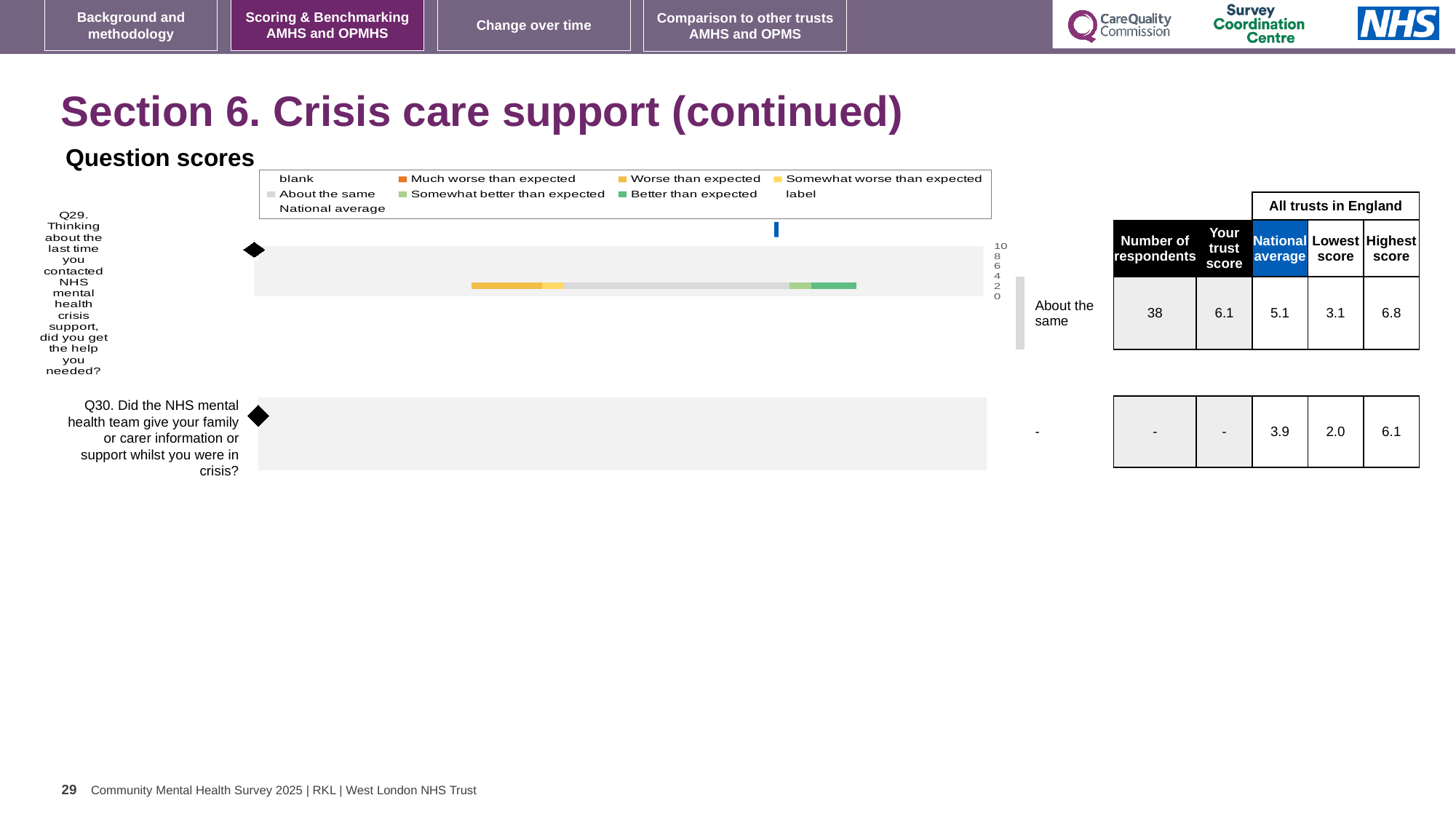
What is the highest score among all trusts in England for Q29? 6.8 How many questions are plotted in the question scores chart? 2 What kind of chart is used to show the question scores on this slide? bar chart What is the national average for Q29? 5.1 What is the trust's score for Q29? 6.1 What is the lowest score among all trusts in England for Q30? 2.0 Which is larger for Q29, the trust's score or the national average? the trust's score What is the difference between the highest and lowest scores for Q29? 3.7 Which benchmark category is shown for Q29 next to the chart? About the same Which question has the higher national average, Q29 or Q30? Q29 What colour does the legend use for 'Better than expected'? green What is the number of respondents for Q29 in the table beside the chart? 38